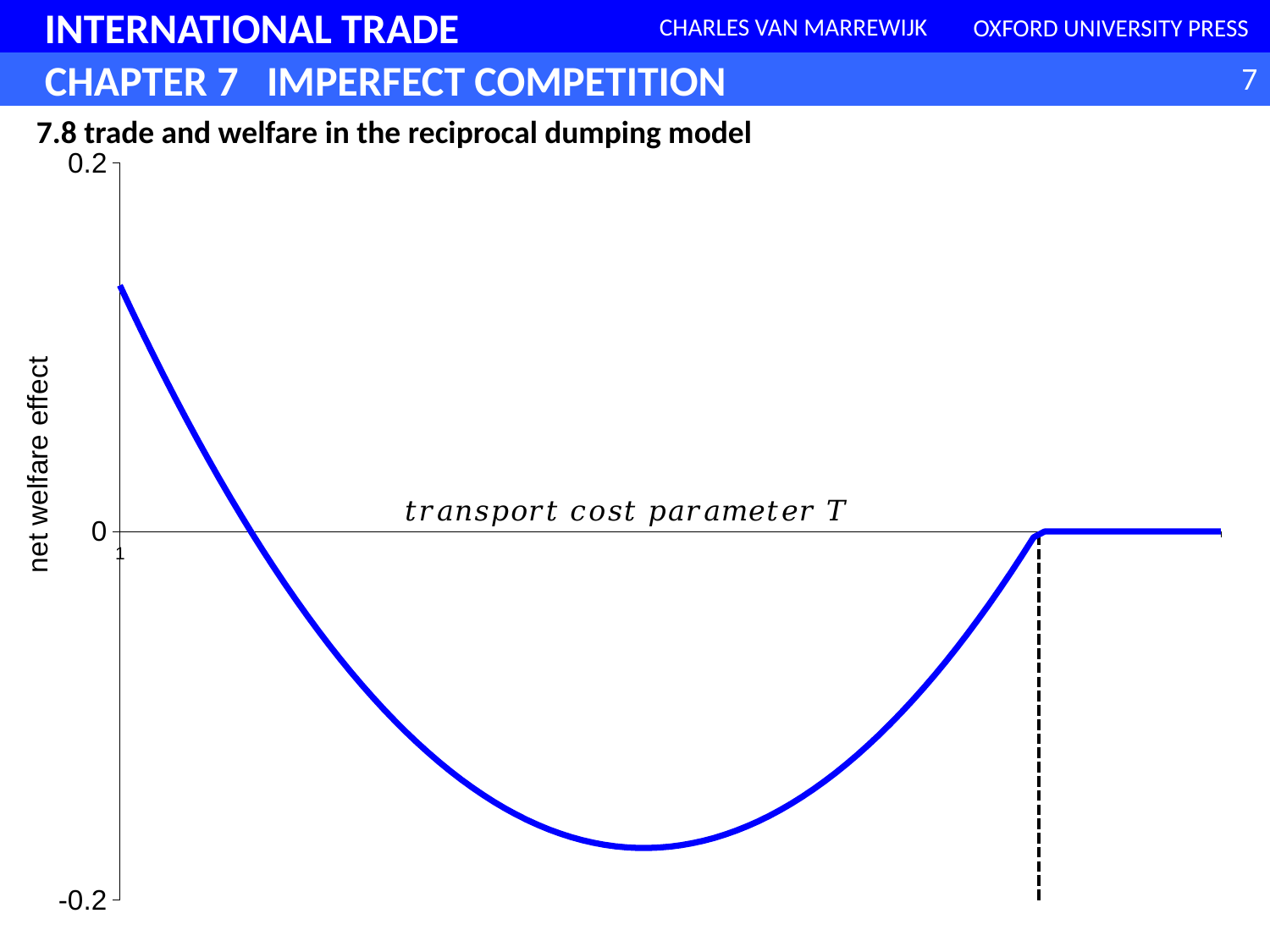
What value does the net welfare effect curve settle at to the right of the dashed vertical line? 0 Is the net welfare effect at T = 1 greater or less than 0? greater What is the label on the vertical axis? net welfare effect What is the title of the chart? 7.8 trade and welfare in the reciprocal dumping model How many lines are plotted on the chart? 1 Does the net welfare effect rise or fall as T increases from its starting value of 1? fall What is the label on the horizontal axis? transport cost parameter T Is the net welfare effect at T = 1 greater or less than 0.2? less What kind of chart is shown on the slide? line chart Is the lowest point of the net welfare effect curve greater or less than -0.2? greater